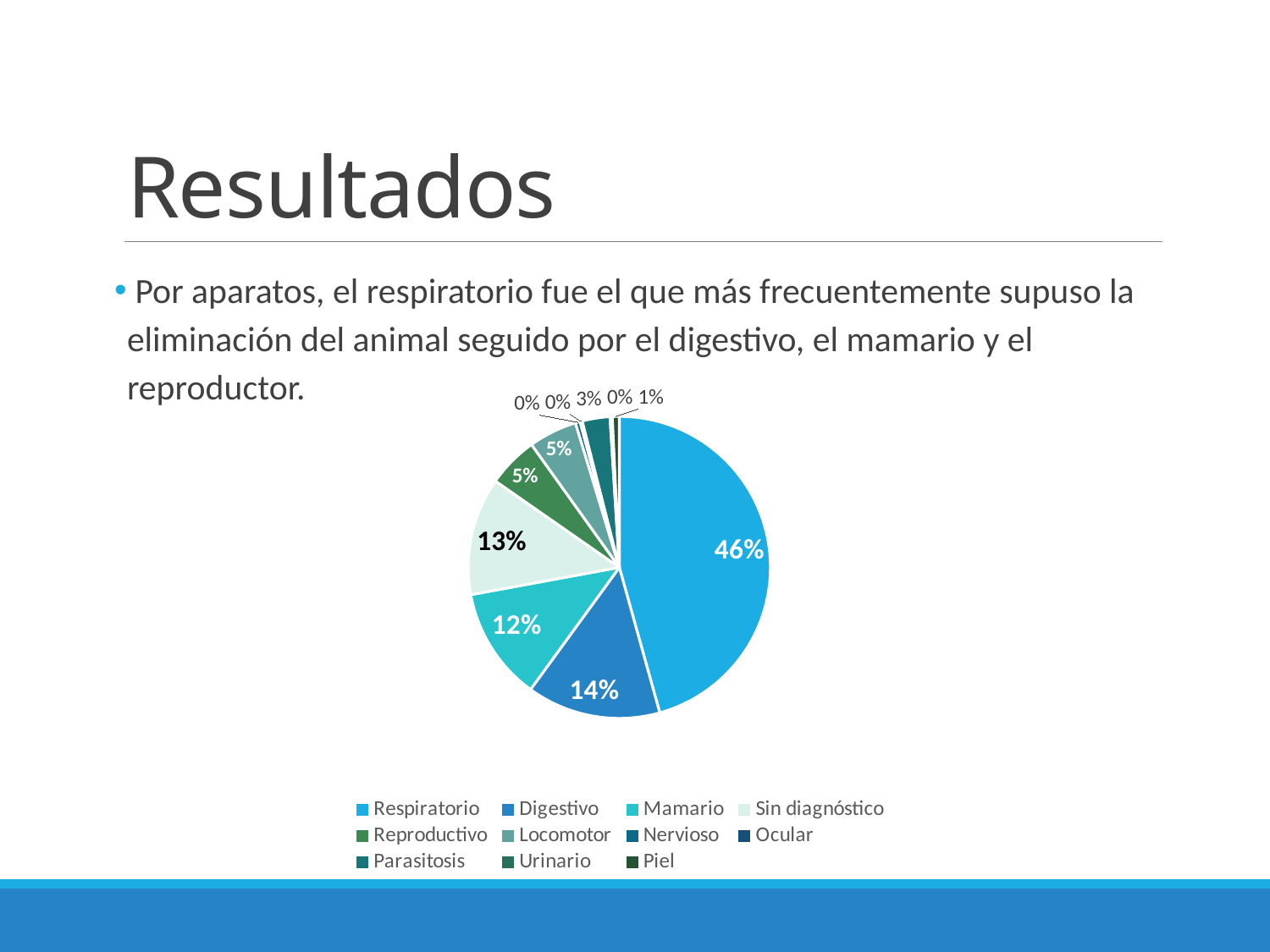
What kind of chart is shown on the slide? pie chart What is the title of the slide containing the pie chart? Resultados How many percentage points larger is Respiratorio than Digestivo? 32 What percentage is labelled for Mamario? 12% How many categories does the legend list? 11 Which category has the largest slice of the pie? Respiratorio What share of the pie is Sin diagnóstico? 13% What is the share shown for Digestivo? 14% What is the combined share of Digestivo and Mamario? 26% Which is larger, the share for Sin diagnóstico or the share for Mamario? Sin diagnóstico What percentage is shown for Reproductivo? 5% What percentage of the pie does Respiratorio account for? 46%